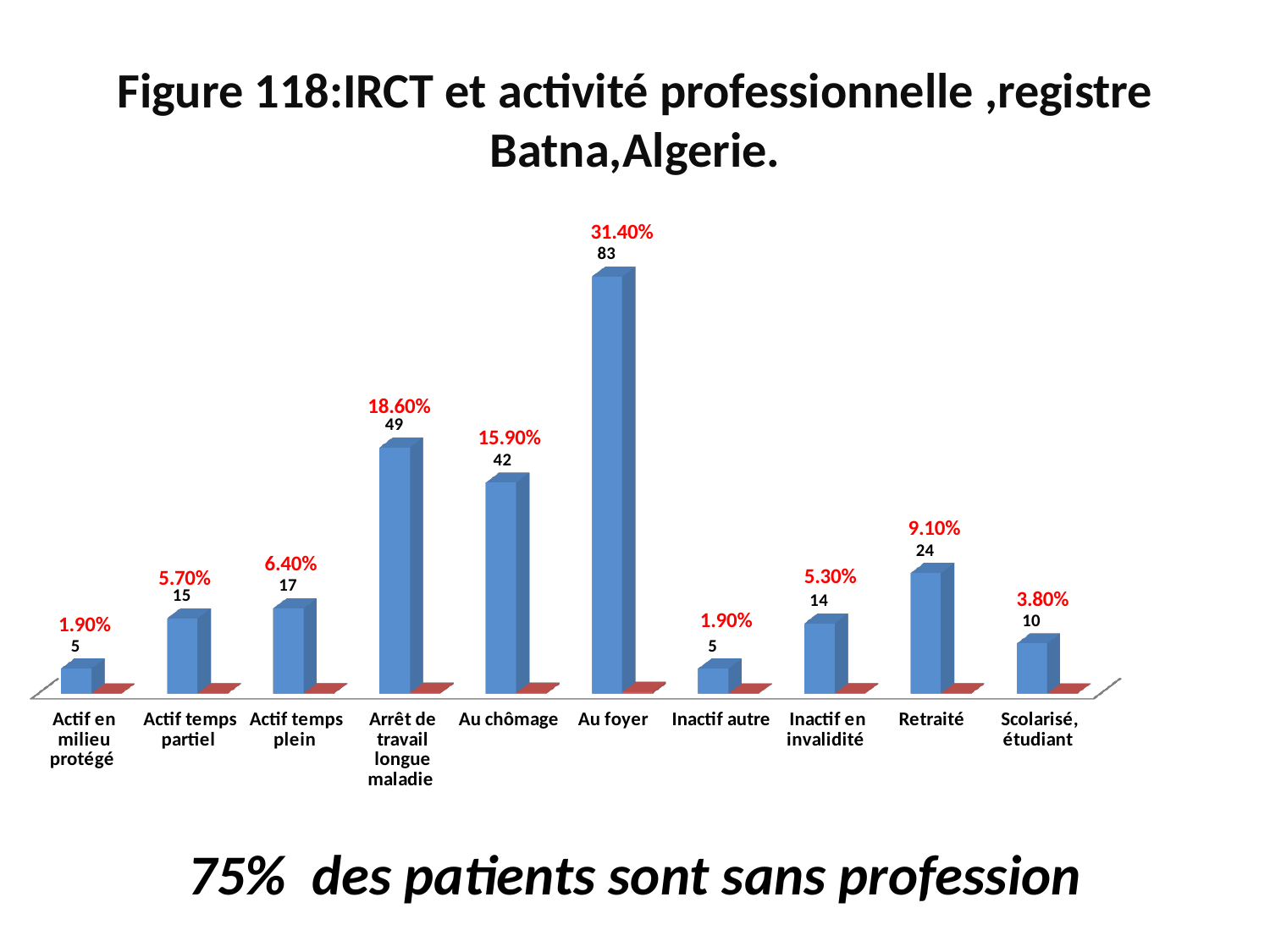
Which is larger, the count for Actif temps plein or the count for Actif temps partiel? Actif temps plein What percentage is shown for Au chômage? 15.90% How many categories are shown on the x axis? 10 What is the count for Au foyer? 83 What is the count for Retraité? 24 What is the title of the chart? Figure 118:IRCT et activité professionnelle ,registre Batna,Algerie. What kind of chart is this? Bar chart Which category has the highest count? Au foyer What percentage is shown for Arrêt de travail longue maladie? 18.60% What percentage is shown for Scolarisé, étudiant? 3.80% What is the difference in count between Au foyer and Arrêt de travail longue maladie? 34 What is the difference in count between Retraité and Inactif en invalidité? 10